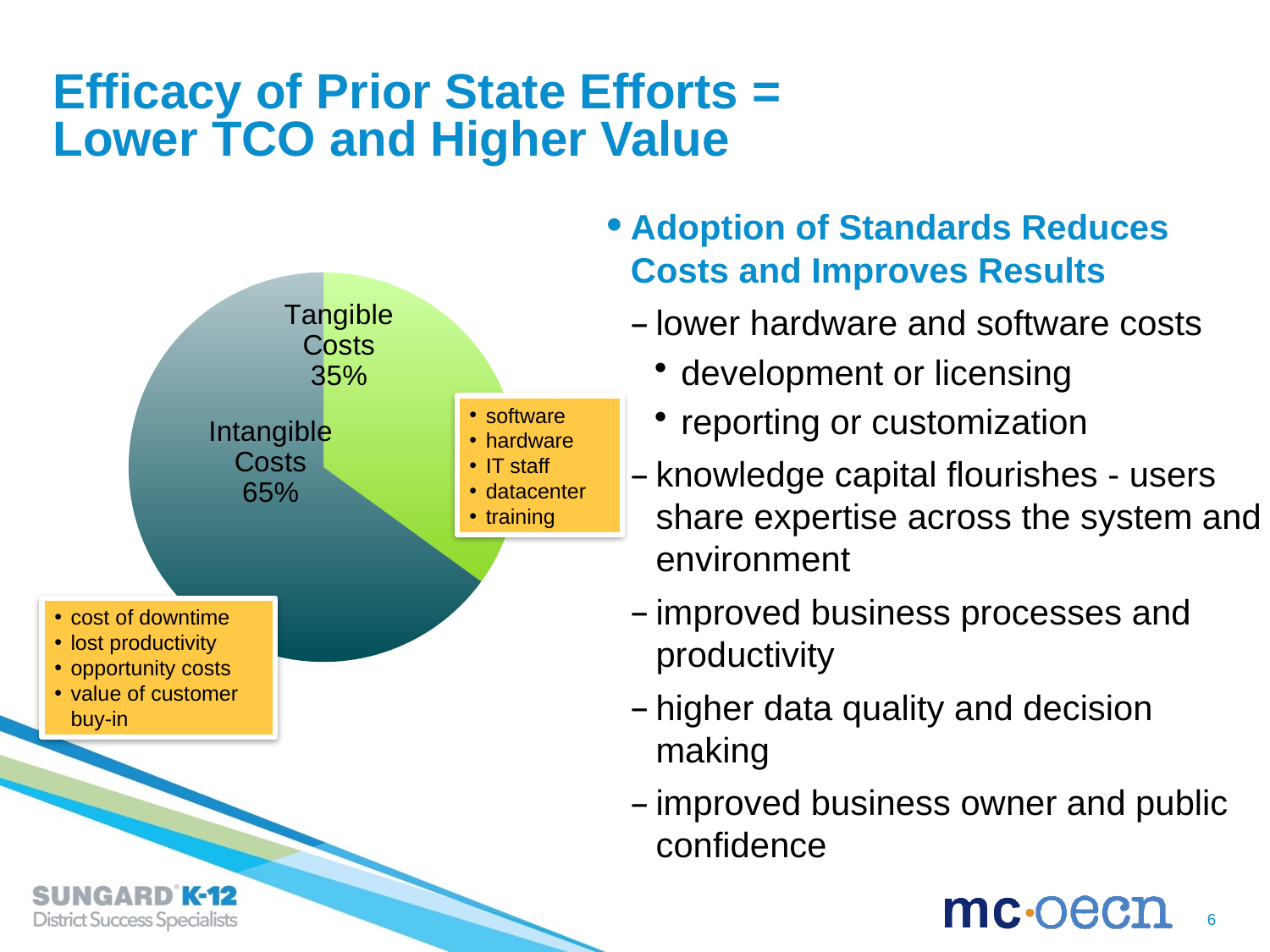
Which is larger, Tangible Costs or Intangible Costs? Intangible Costs What share of the pie is Intangible Costs? 65% What is the difference in percentage points between Intangible Costs and Tangible Costs? 30 percentage points How many slices does the pie chart have? 2 Which slice of the pie is the largest? Intangible Costs What is the total of the two pie slices? 100% How many items are listed in the callout box next to the Tangible Costs slice? 5 Which slice of the pie is the smallest? Tangible Costs What colour is the Tangible Costs slice? green What kind of chart is shown on the slide? pie chart What share of the pie is Tangible Costs? 35%